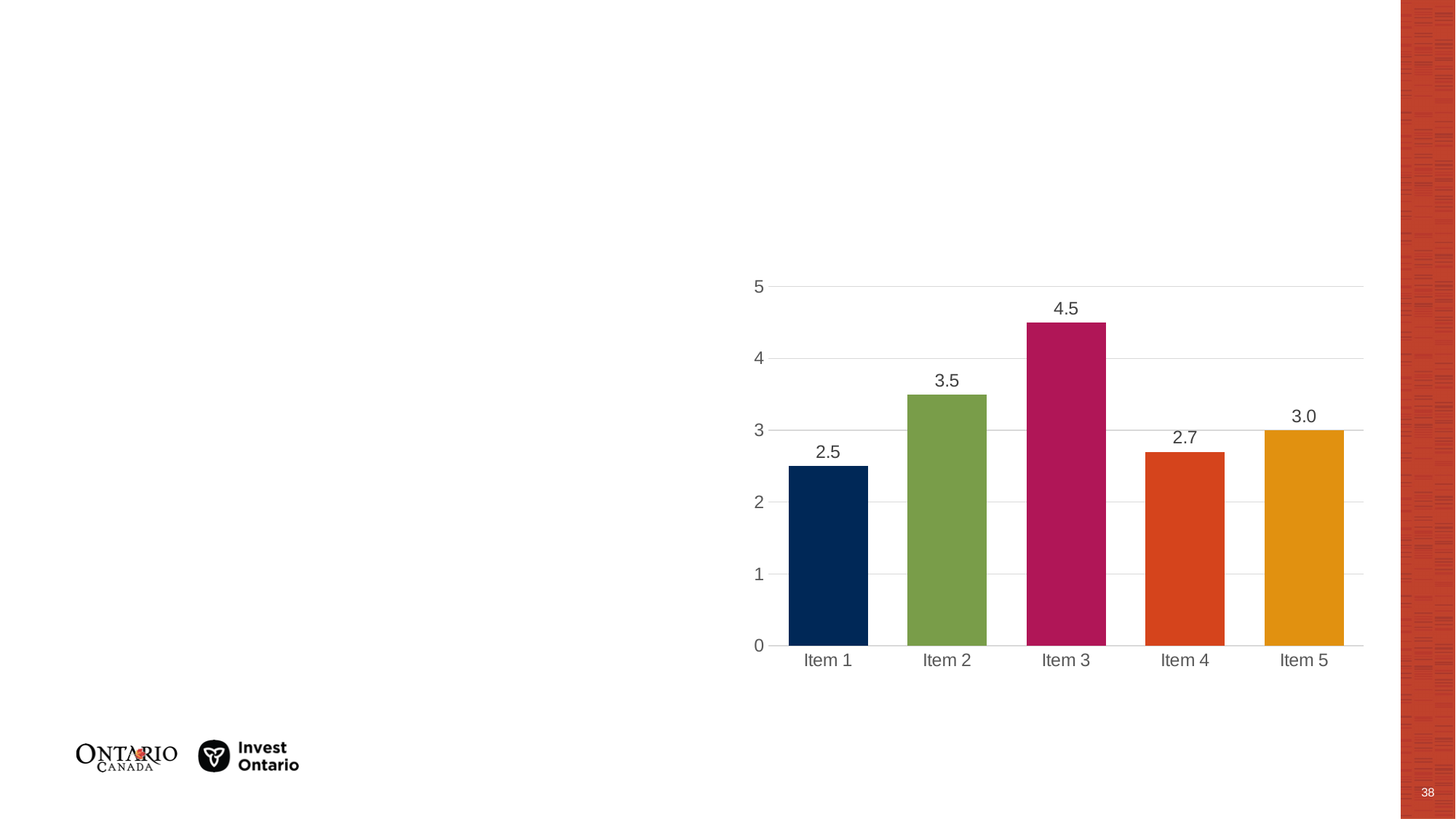
What colour is the bar for Item 3? Magenta Is the value for Item 3 greater or less than 4? greater Which is larger, the value for Item 2 or the value for Item 4? Item 2 What is the value for Item 3? 4.5 Which item has the highest value? Item 3 How many items are shown on the chart? 5 What is the value for Item 4? 2.7 What is the value for Item 1? 2.5 What kind of chart is shown on the slide? Bar chart Which item has the lowest value? Item 1 What is the difference between the values for Item 3 and Item 1? 2.0 What is the difference between the values for Item 2 and Item 5? 0.5